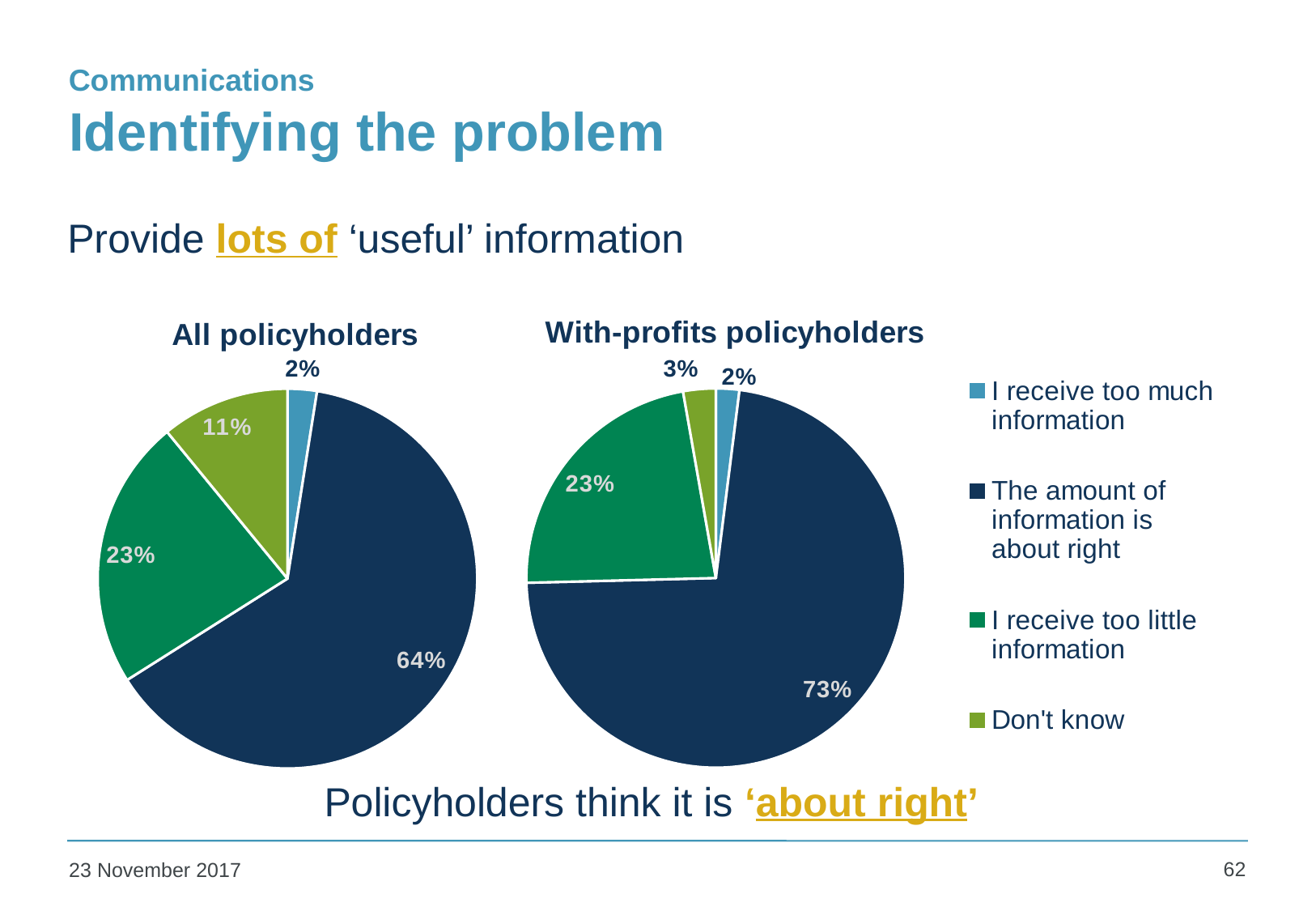
What type of chart is used for 'All policyholders'? Pie chart Which colour represents 'I receive too little information' in the legend? Green Which chart has the larger 'Don't know' share, 'All policyholders' or 'With-profits policyholders'? All policyholders In the 'All policyholders' chart, which response has the largest slice? The amount of information is about right In the 'All policyholders' chart, what share of respondents say the amount of information is about right? 64% In the 'All policyholders' chart, what share of respondents say they receive too little information? 23% In the 'With-profits policyholders' chart, what share of respondents answered 'Don't know'? 3% In the 'With-profits policyholders' chart, which response has the smallest slice? I receive too much information In the 'All policyholders' chart, what share of respondents answered 'Don't know'? 11% In the 'With-profits policyholders' chart, what share of respondents say the amount of information is about right? 73% What is the difference between the 'about right' share in the 'With-profits policyholders' chart and the 'All policyholders' chart? 9% How many categories does the legend list? 4